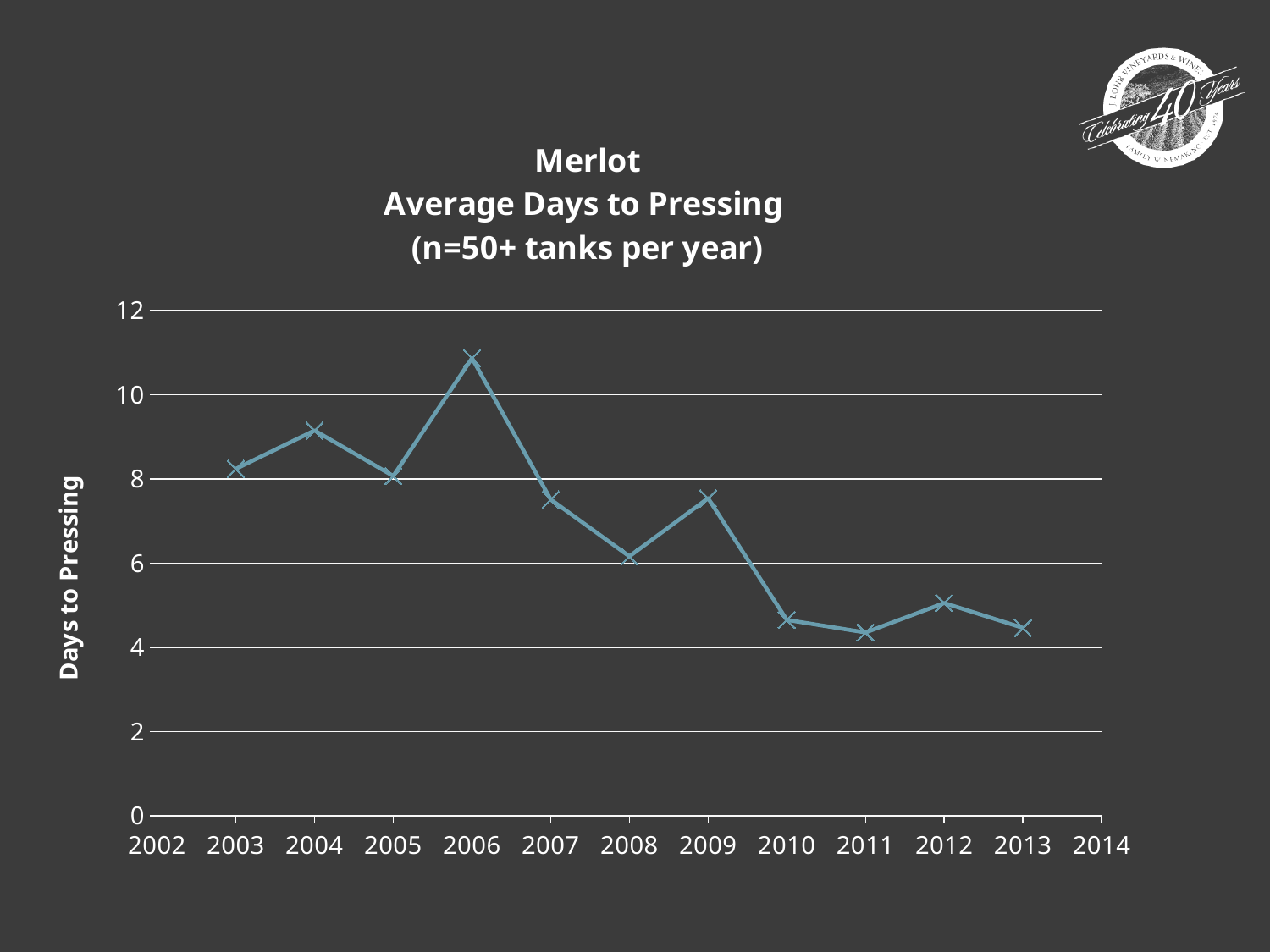
Is the value for 2011 greater or less than 6? less What is the label on the vertical axis? Days to Pressing Which year has the larger value, 2004 or 2007? 2004 What kind of chart is shown on the slide? line chart Is the value for 2006 greater or less than 10? greater Is the value for 2007 greater or less than 8? less How many data points are plotted on the line? 11 Overall, do the values rise or fall from 2003 to 2013? fall Which year has the highest average days to pressing? 2006 Which year has the larger value, 2009 or 2010? 2009